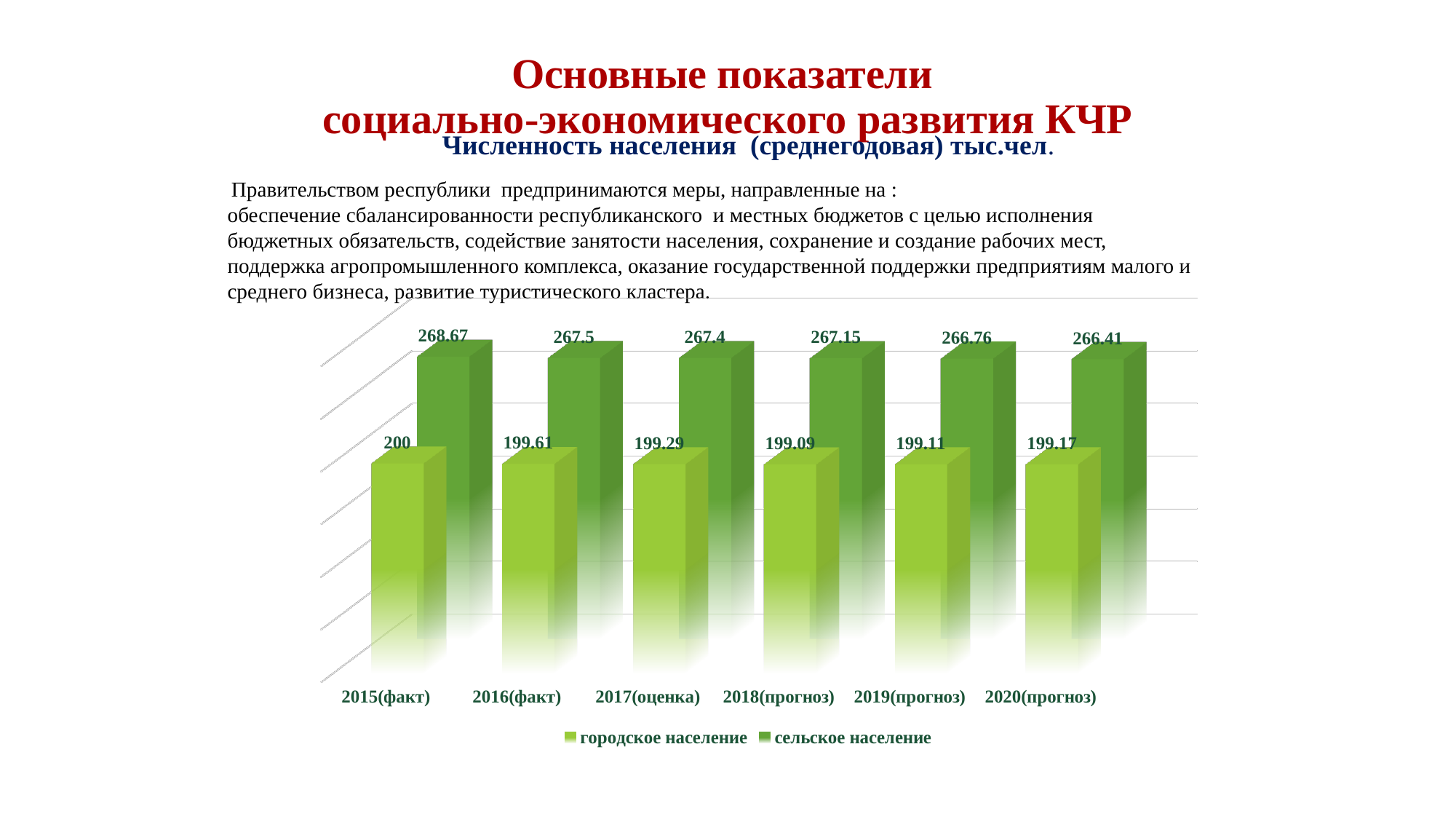
How many years (categories) are shown on the x axis? 6 What is the value for городское население in 2018(прогноз)? 199.09 What is the value for городское население in 2016(факт)? 199.61 How many series does the legend list? 2 Does the value for сельское население rise or fall from 2015(факт) to 2020(прогноз)? fall In which year is the value for сельское население highest? 2015(факт) What is the value for сельское население in 2015(факт)? 268.67 What is the difference between the сельское население values for 2015(факт) and 2020(прогноз)? 2.26 In which year is the value for сельское население lowest? 2020(прогноз) What is the difference between сельское население and городское население in 2015(факт)? 68.67 What is the value for сельское население in 2020(прогноз)? 266.41 Which is larger in 2017(оценка): городское население or сельское население? сельское население